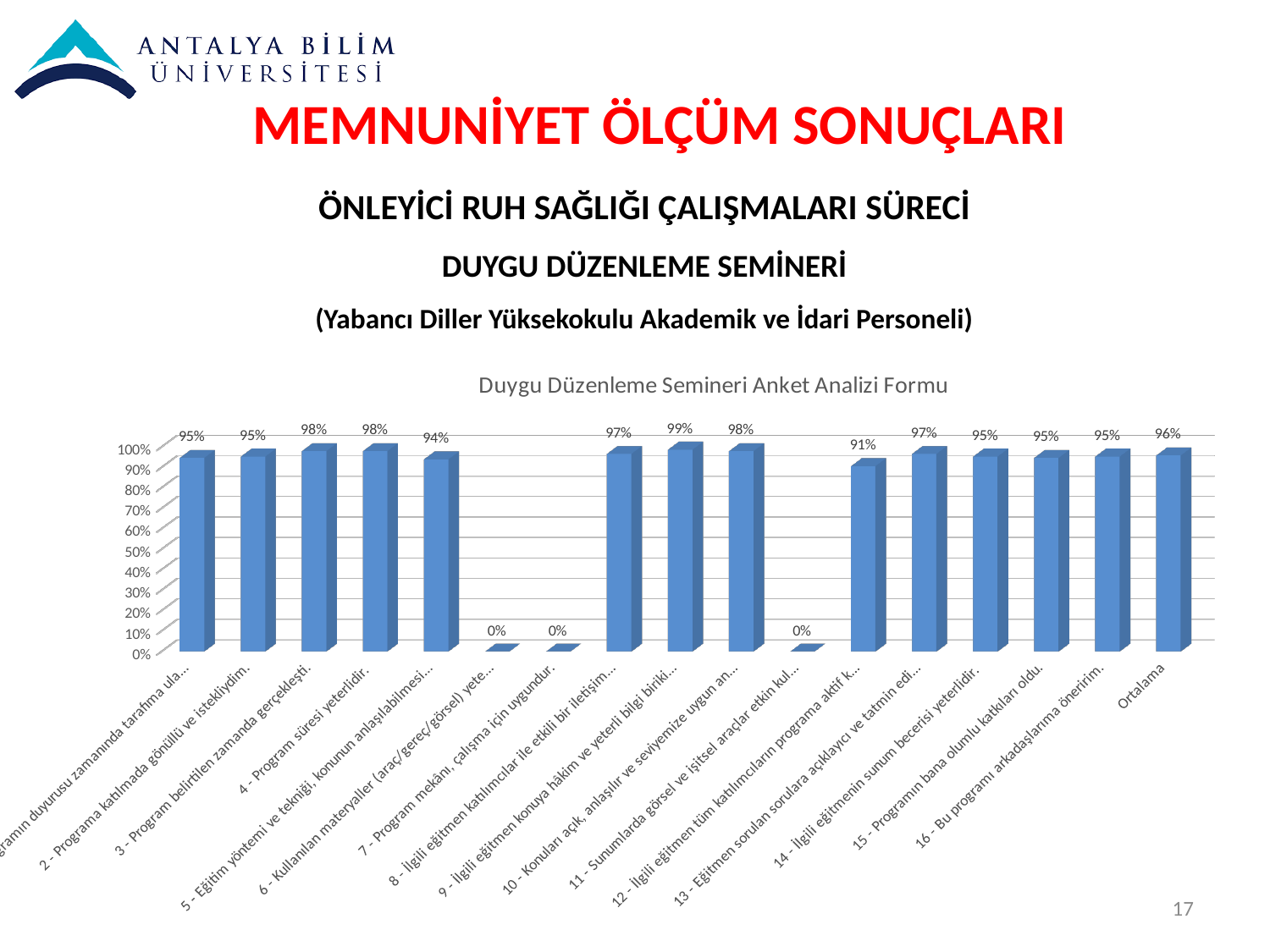
What is the value for "3 - Program belirtilen zamanda gerçekleşti."? 98% How many bars are plotted in the chart? 17 Which is larger: the value for "14 - İlgili eğitmenin sunum becerisi yeterlidir." or the value for "Ortalama"? Ortalama How many categories have a value of 0%? 3 What is the title of the chart? Duygu Düzenleme Semineri Anket Analizi Formu What is the value for "4 - Program süresi yeterlidir."? 98% What is the highest value shown in the chart? 99% What is the value for "Ortalama"? 96% Which category has the highest value? 9 - İlgili eğitmen konuya hâkim ve yeterli bilgi biriki... What is the value for "15 - Programın bana olumlu katkıları oldu."? 95% What type of chart is shown on the slide? Bar chart What is the difference between the value for "4 - Program süresi yeterlidir." and the value for "Ortalama"? 2%